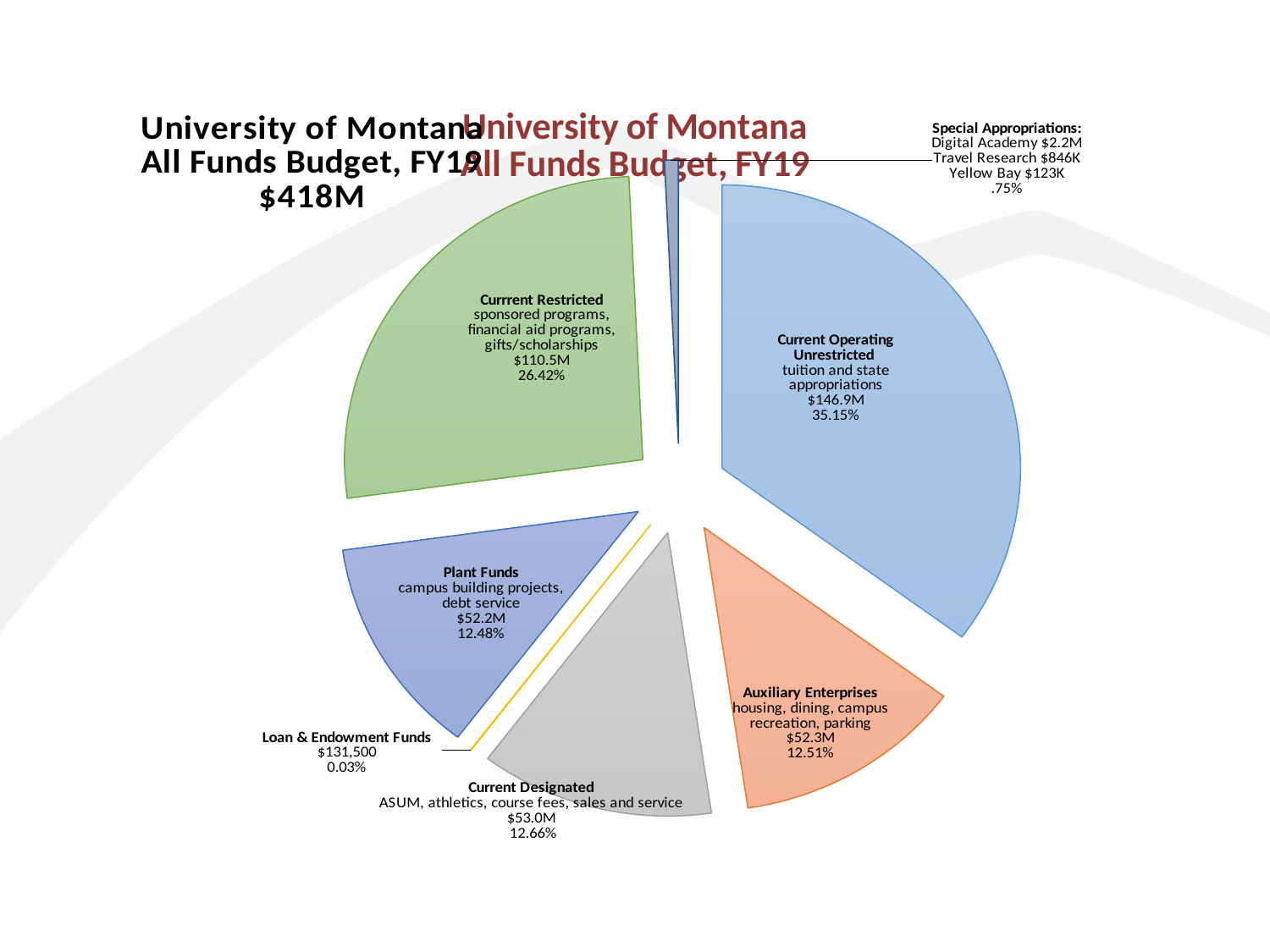
What total budget amount is stated in the chart title? $418M What is the dollar value of the Plant Funds slice? $52.2M What percentage of the budget is Current Restricted? 26.42% What share of the pie do Auxiliary Enterprises represent? 12.51% Which category is the smallest slice of the pie? Loan & Endowment Funds What is the difference in dollars between Current Operating Unrestricted and Current Restricted? $36.4M Which category is the largest slice of the pie? Current Operating Unrestricted Which is larger, Current Designated or Plant Funds? Current Designated What type of chart is shown on the slide? pie chart What is the dollar value of Loan & Endowment Funds? $131,500 How many slices does the pie chart have? 7 What is the dollar value of the Current Operating Unrestricted slice? $146.9M